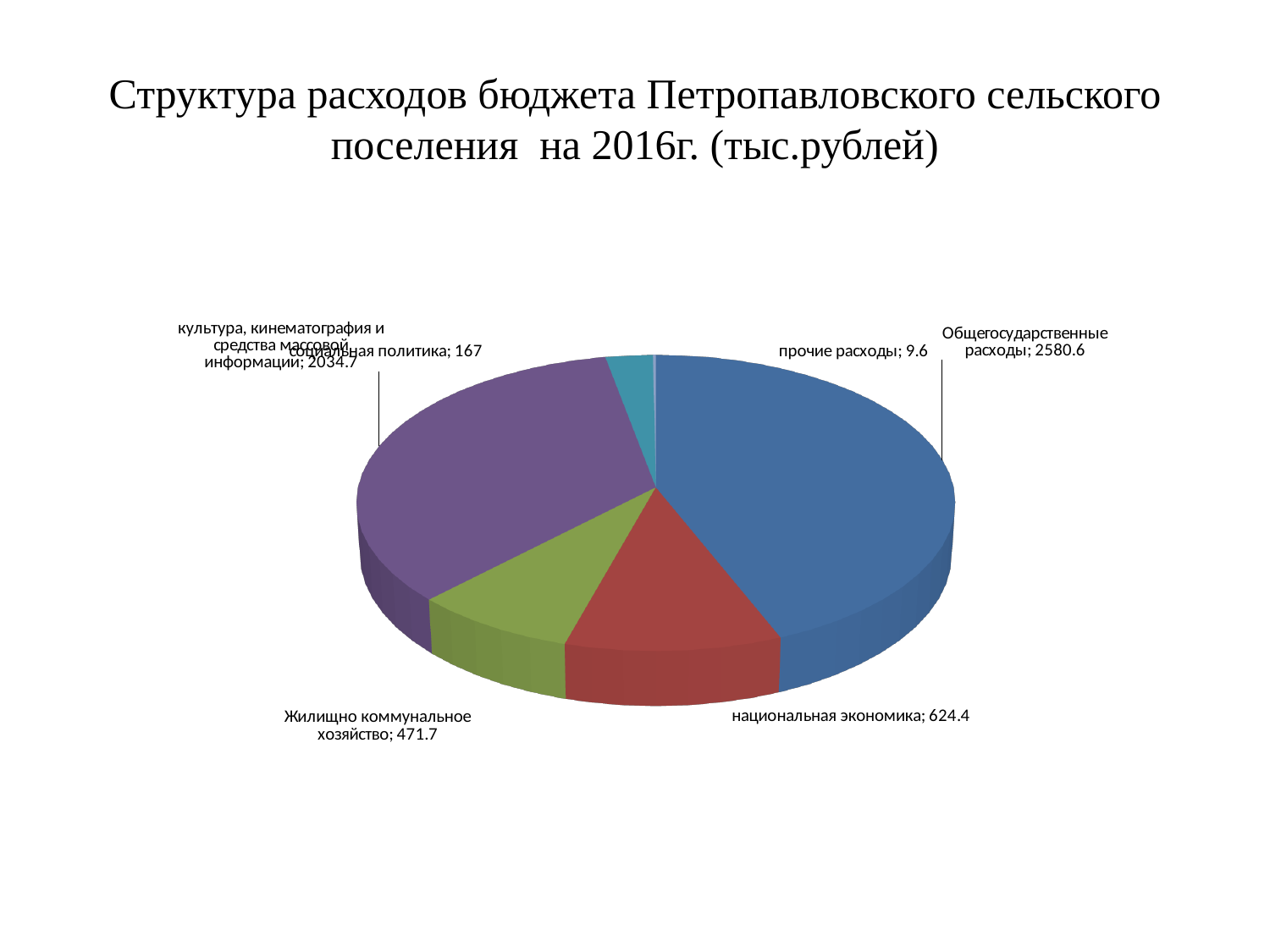
What is the value for Жилищно коммунальное хозяйство? 471.7 What is the value for культура, кинематография и средства массовой информации? 2034.7 What is the difference between Общегосударственные расходы and культура, кинематография и средства массовой информации? 545.9 What kind of chart is shown on the slide? Pie chart Which is larger, национальная экономика or Жилищно коммунальное хозяйство? национальная экономика What is the value for прочие расходы? 9.6 Which category has the smallest value? прочие расходы What is the value for Общегосударственные расходы? 2580.6 How many slices does the pie chart have? 6 Which category has the largest value? Общегосударственные расходы What is the value for национальная экономика? 624.4 What is the title of the chart on the slide? Структура расходов бюджета Петропавловского сельского поселения на 2016г. (тыс.рублей)